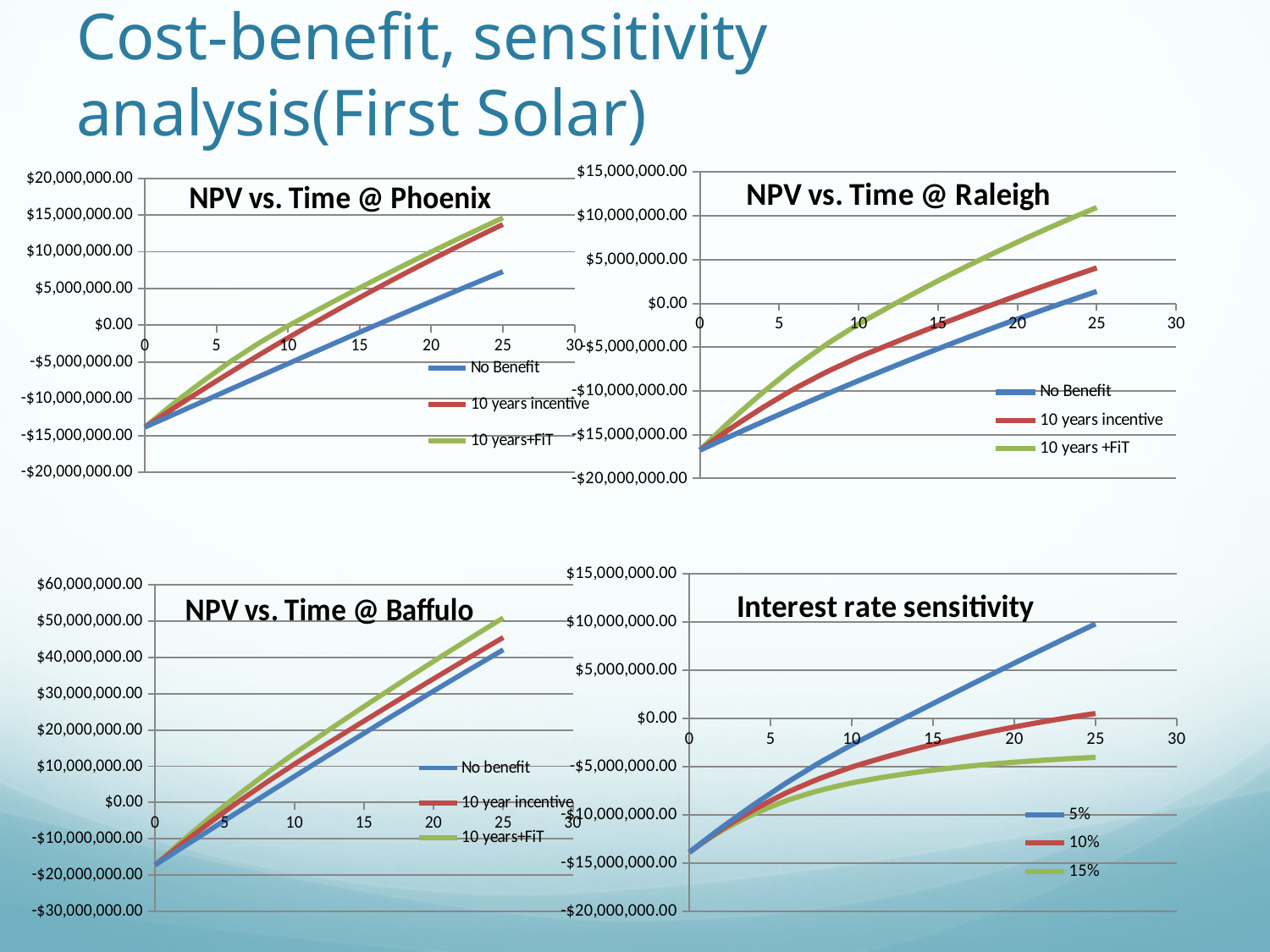
In 'NPV vs. Time @ Baffulo', is the value of '10 years+FiT' at year 25 greater or less than $40,000,000.00? greater In 'NPV vs. Time @ Baffulo', which series has the lowest value at year 25? No benefit In 'NPV vs. Time @ Phoenix', does the 'No Benefit' series rise or fall as time increases? rise How many series does the legend of 'Interest rate sensitivity' list? 3 In 'NPV vs. Time @ Phoenix', is the value of '10 years+FiT' at year 25 greater or less than $10,000,000.00? greater What are the legend entries of the 'Interest rate sensitivity' chart? 5%, 10%, 15% How many series does the legend of 'NPV vs. Time @ Phoenix' list? 3 In 'Interest rate sensitivity', is the value of the '15%' series at year 25 greater or less than $0.00? less In 'Interest rate sensitivity', which series has the highest value at year 25? 5% In 'NPV vs. Time @ Raleigh', which series has the larger value at year 25: '10 years +FiT' or 'No Benefit'? 10 years +FiT What kind of chart is 'NPV vs. Time @ Phoenix'? line chart